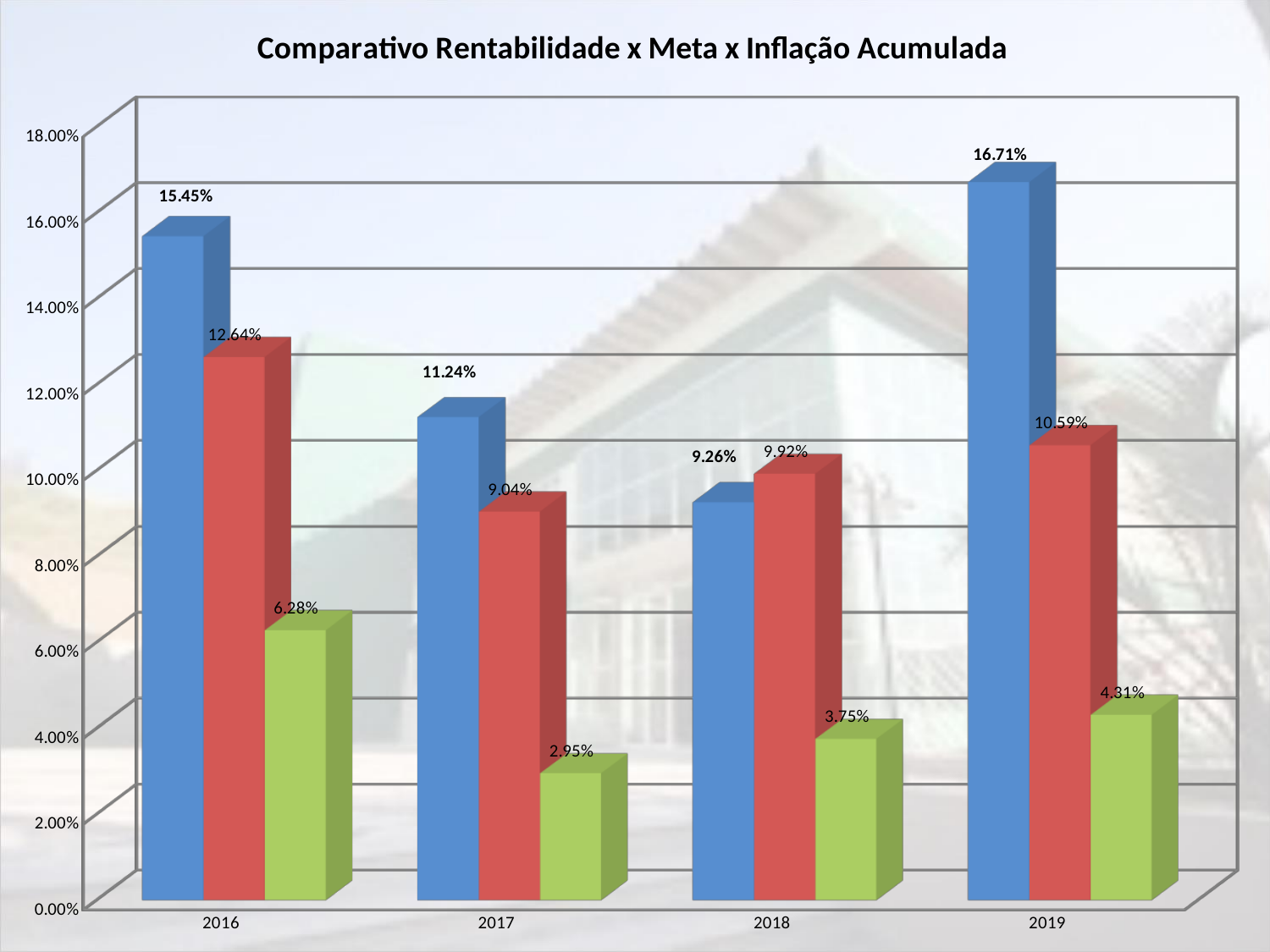
What type of chart is shown on the slide? bar chart What is the value of the blue bar for 2019? 16.71% What is the difference between the blue bar and the red bar in 2016? 2.81% What is the title of the chart? Comparativo Rentabilidade x Meta x Inflação Acumulada In which year is the blue bar highest? 2019 What is the value of the green bar for 2018? 3.75% In which year is the green bar lowest? 2017 Which is larger in 2018, the blue bar or the red bar? the red bar How many years are shown on the x axis? 4 What is the value of the red bar for 2016? 12.64% What is the value of the red bar for 2017? 9.04% Does the green bar rise or fall from 2016 to 2017? fall